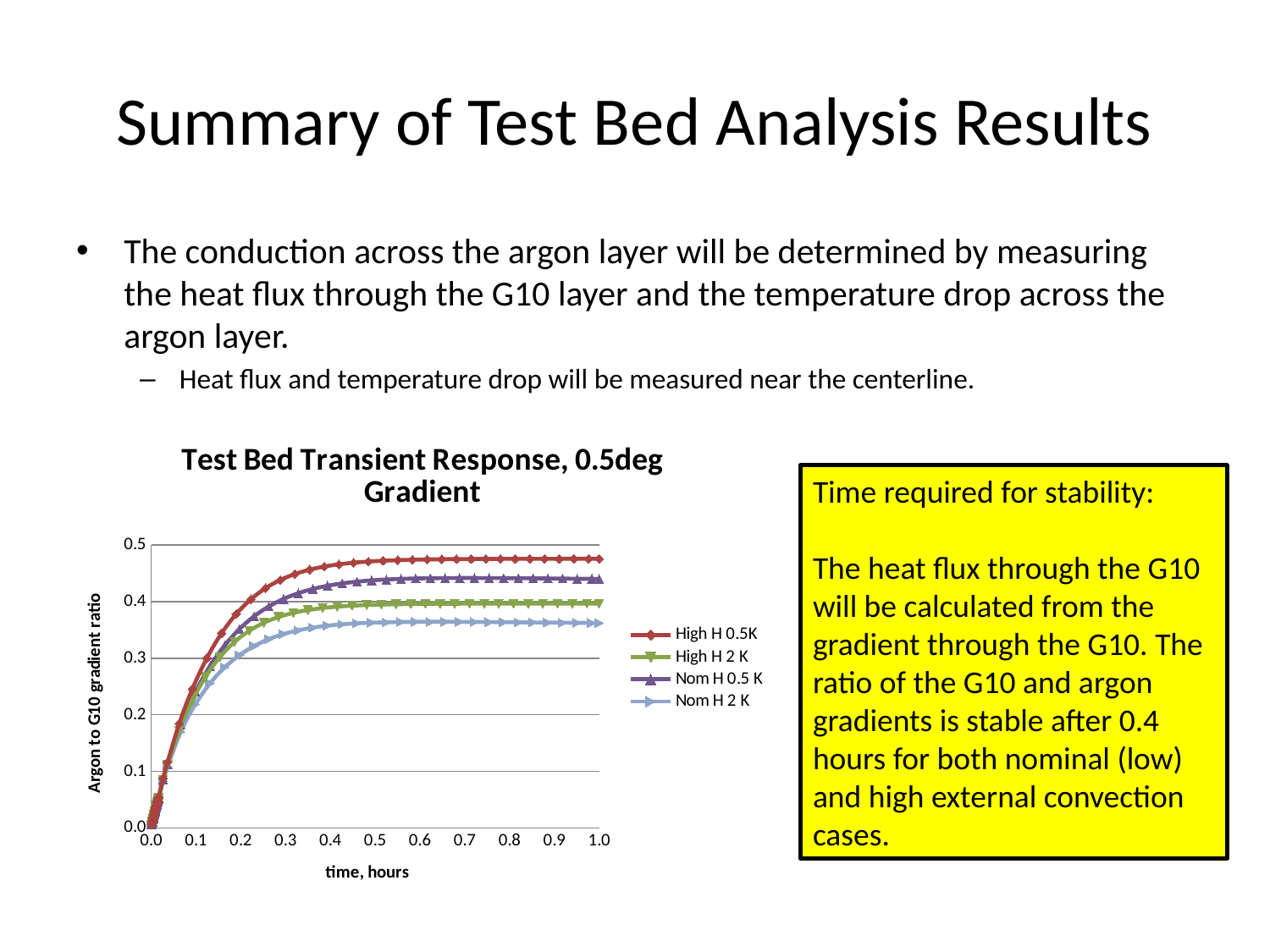
What is the label of the x axis of the chart? time, hours How many series does the chart legend list? 4 Is the value for Nom H 0.5 K at 1.0 hours greater or less than 0.4? greater Do the values of the High H 0.5K series rise or fall as time increases from 0.0 to 0.4 hours? rise What is the title of the chart? Test Bed Transient Response, 0.5deg Gradient Is the value for High H 0.5K at 1.0 hours greater or less than 0.4? greater Is the value for Nom H 2 K at 1.0 hours greater or less than 0.4? less At 0.5 hours, which is larger: High H 0.5K or Nom H 2 K? High H 0.5K Which series has the lowest value at 1.0 hours? Nom H 2 K What kind of chart is shown on the slide? line chart Which series has the highest value at 1.0 hours? High H 0.5K